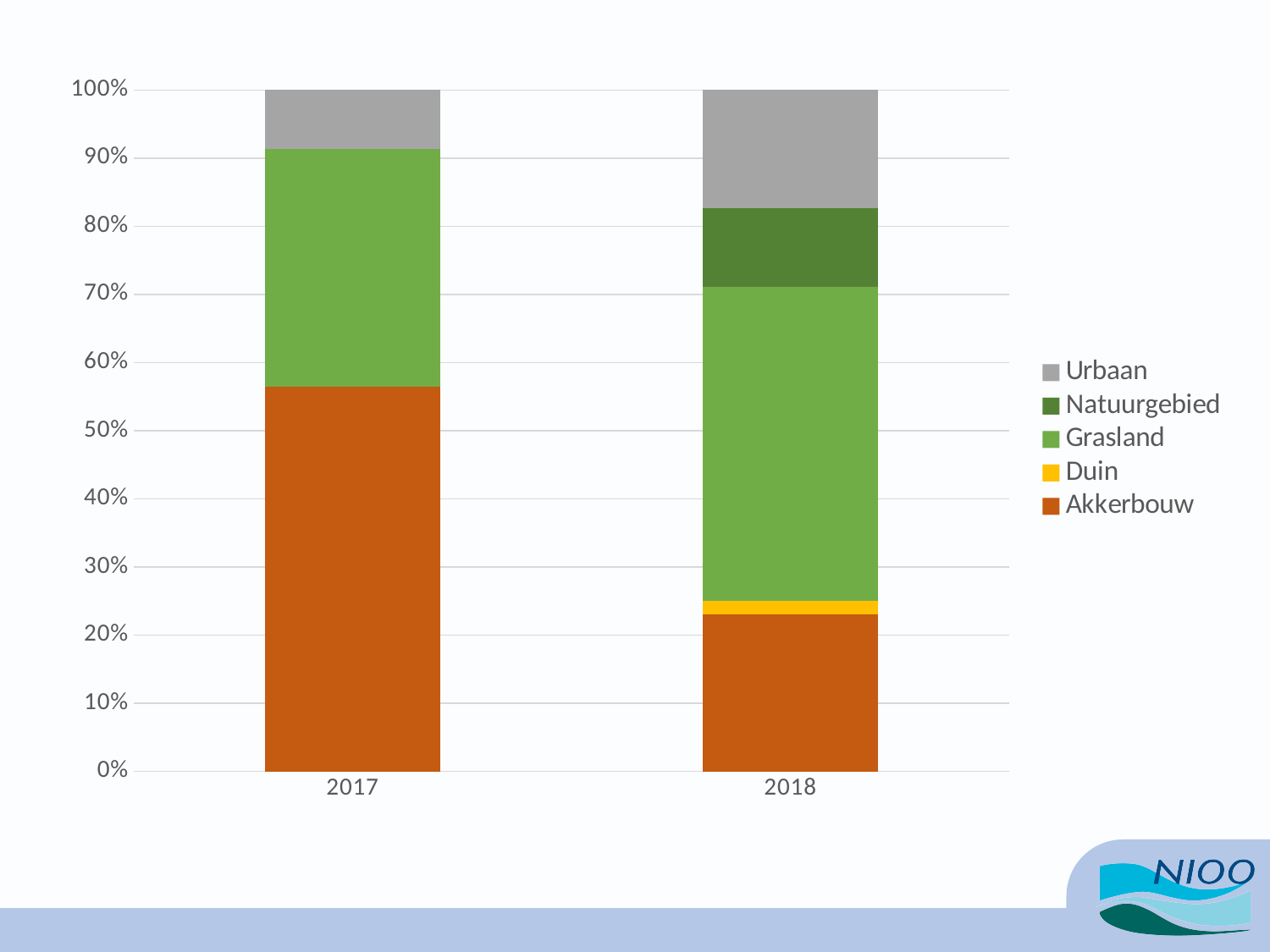
Which year has the larger Urbaan share, 2017 or 2018? 2018 Which series is shown in grey in the legend? Urbaan Is the Duin share in 2018 greater or less than 10%? less Which year has the larger Akkerbouw share, 2017 or 2018? 2017 Which series has the smallest segment in the 2018 bar? Duin Which series is shown in yellow in the legend? Duin How many years (categories) are shown on the x axis? 2 Is the Akkerbouw share in 2018 greater or less than 30%? less What kind of chart is shown on the slide? Stacked bar chart Which series has the largest segment in the 2018 bar? Grasland How many series does the legend list? 5 Is the Akkerbouw share in 2017 greater or less than 50%? greater